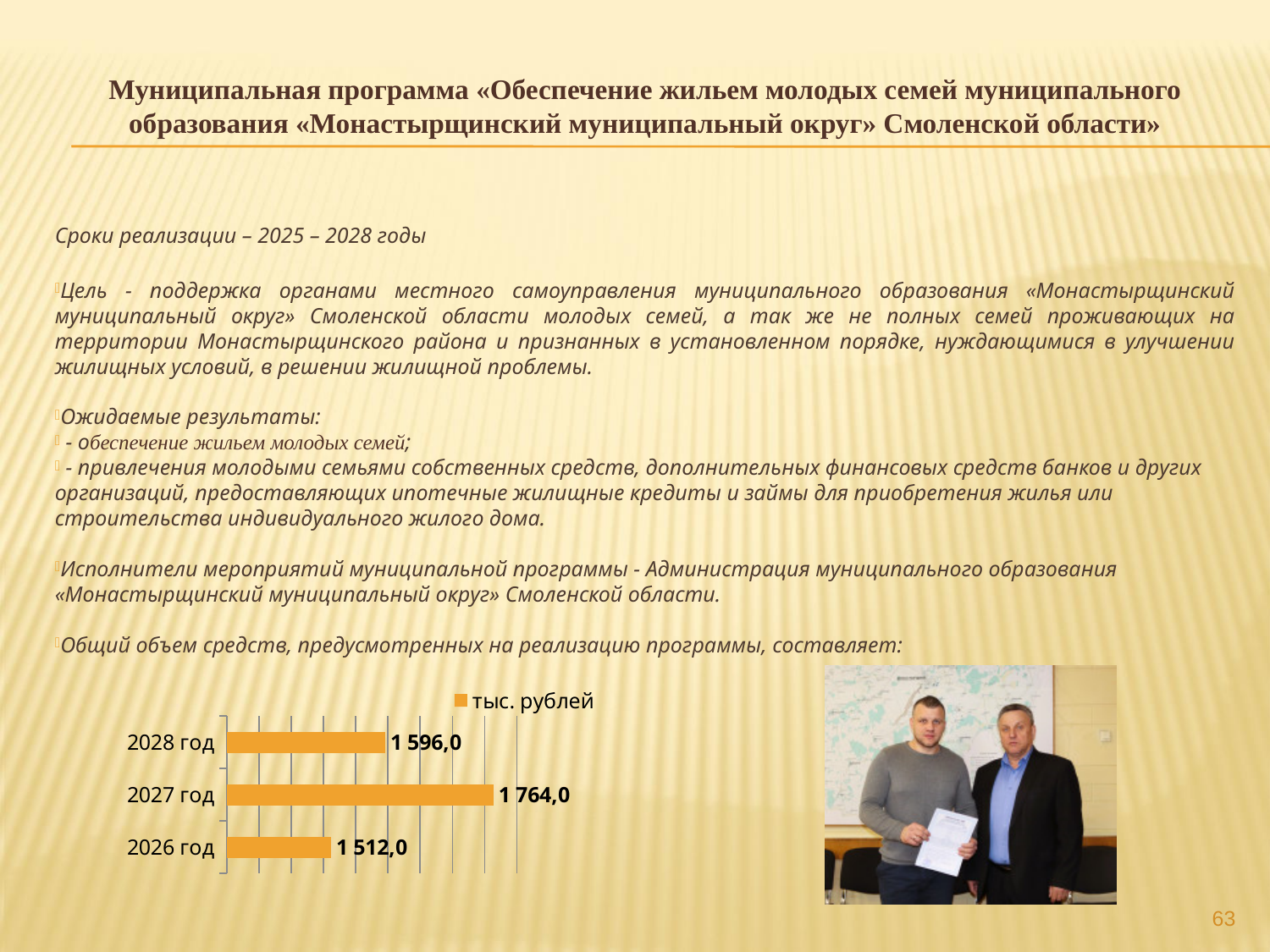
What kind of chart is shown on the slide? Bar chart What value does the chart show for 2027 год? 1 764,0 What value does the chart show for 2026 год? 1 512,0 Which is larger, the value for 2028 год or the value for 2026 год? 2028 год What is the legend entry of the chart? тыс. рублей Which year has the lowest value in the chart? 2026 год What value does the chart show for 2028 год? 1 596,0 How many series does the chart legend list? 1 What is the difference between the values for 2027 год and 2026 год? 252,0 How many years (categories) are shown in the chart? 3 What is the difference between the values for 2028 год and 2026 год? 84,0 Which year has the highest value in the chart? 2027 год